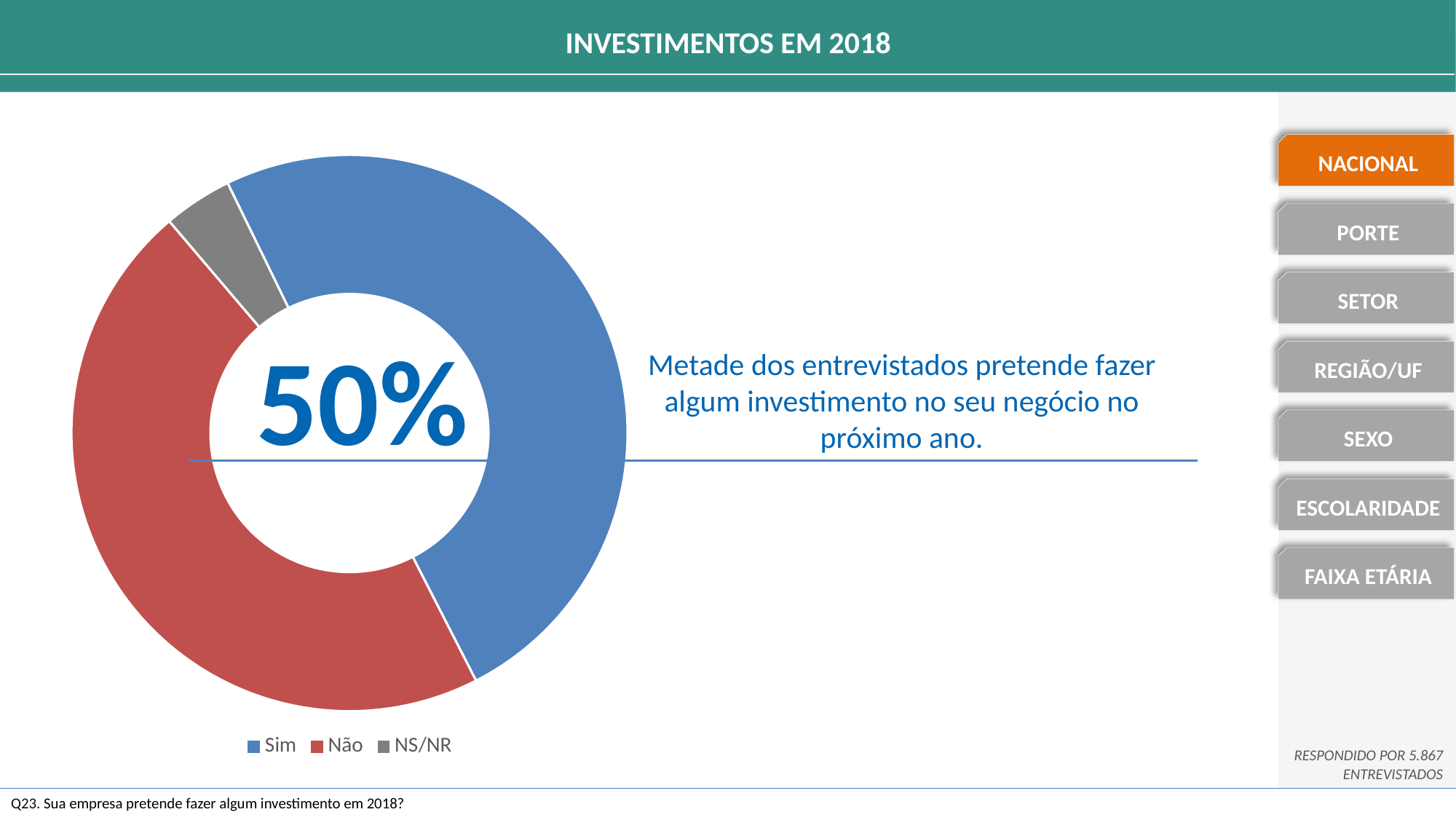
Which slice is larger, 'Não' or 'NS/NR'? Não Which category has the smallest slice? NS/NR What kind of chart is shown on the slide? doughnut (pie) chart What colour is the 'Não' slice? red What is the title of the chart on the slide? INVESTIMENTOS EM 2018 Which category has the largest slice? Sim Which slice is larger, 'Sim' or 'NS/NR'? Sim How many entries does the legend list? 3 How many categories does the chart show? 3 What share of respondents answered 'Sim'? 50% What percentage is printed in the centre of the chart? 50%